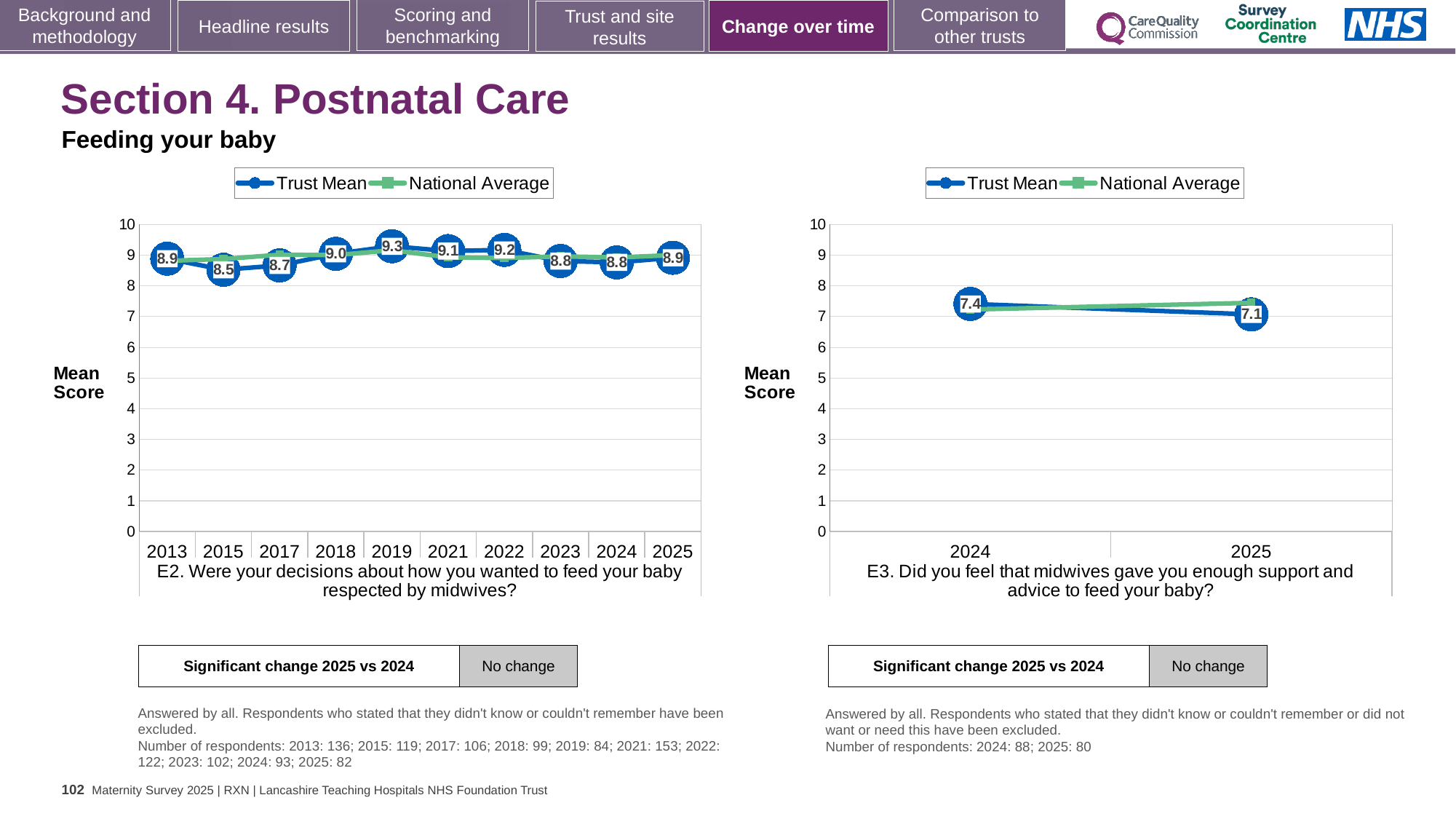
On the E3 chart (right), what is the Trust Mean for 2024? 7.4 On the E3 chart (right), is the Trust Mean for 2025 greater or less than 8? less On the E2 chart (left), what is the Trust Mean for 2019? 9.3 On the E2 chart (left), what is the difference between the Trust Mean in 2019 and in 2015? 0.8 On the E3 chart (right), what is the Trust Mean for 2025? 7.1 How many series does the legend of the E2 chart (left) list? 2 On the E2 chart (left), what is the Trust Mean for 2015? 8.5 On the E2 chart (left), how many years are shown on the x axis? 10 On the E2 chart (left), which year has the highest Trust Mean? 2019 What kind of chart is the E3 chart (right)? line chart On the E3 chart (right), did the Trust Mean rise or fall from 2024 to 2025? fall On the E2 chart (left), which year has the lowest Trust Mean? 2015